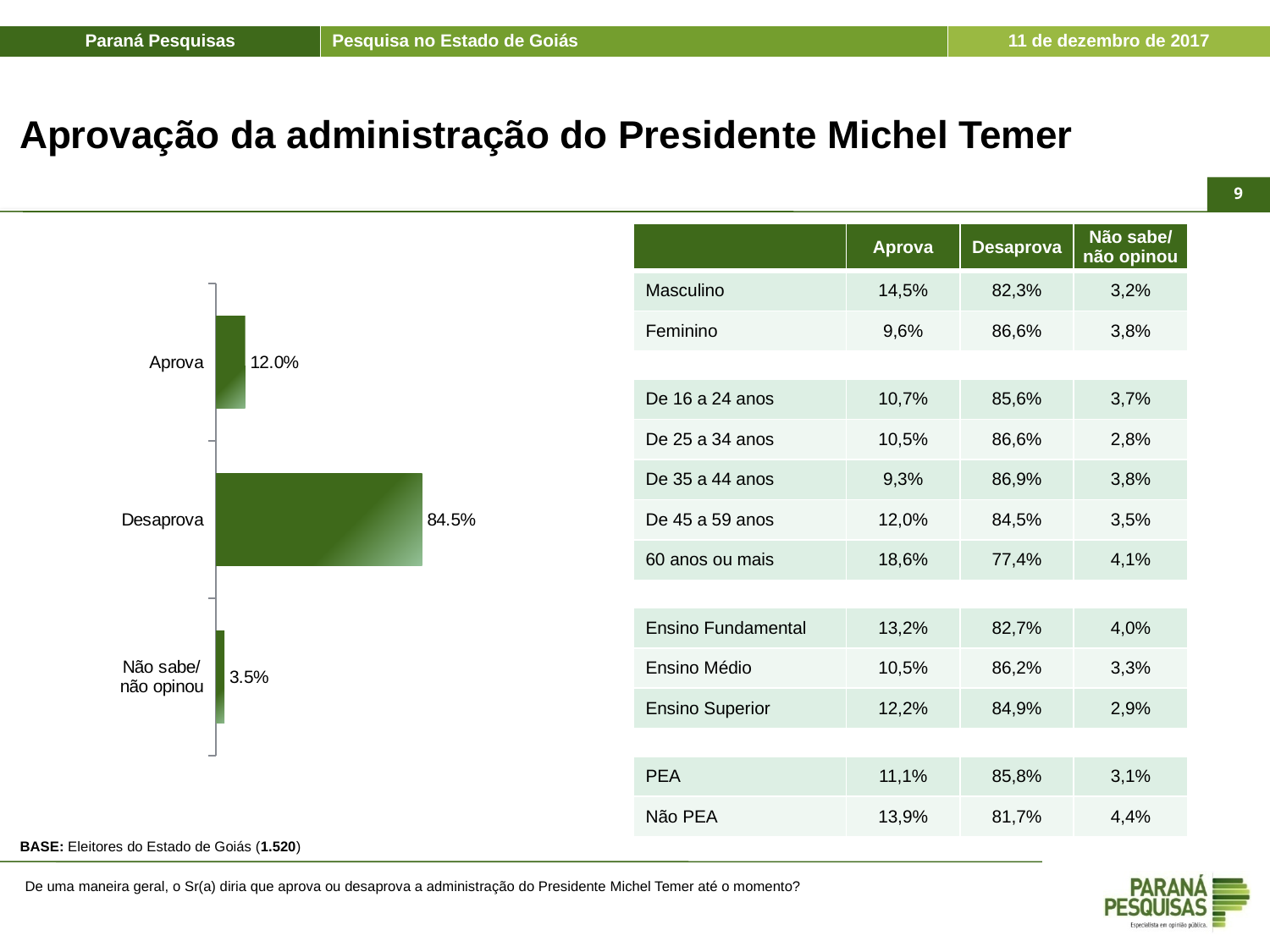
Which category has the highest value in the bar chart? Desaprova What is the value for Aprova in the bar chart? 12.0% What is the value for Não sabe/não opinou in the bar chart? 3.5% What is the value for Desaprova in the bar chart? 84.5% How many categories are shown in the bar chart? 3 What kind of chart is shown on the slide? Bar chart What is the difference between the values for Aprova and Não sabe/não opinou in the bar chart? 8.5% What colour are the bars in the chart? Green What is the total of the three values shown in the bar chart? 100.0% Which is larger in the bar chart, Aprova or Não sabe/não opinou? Aprova Which category has the lowest value in the bar chart? Não sabe/não opinou What is the difference between the values for Desaprova and Aprova in the bar chart? 72.5%